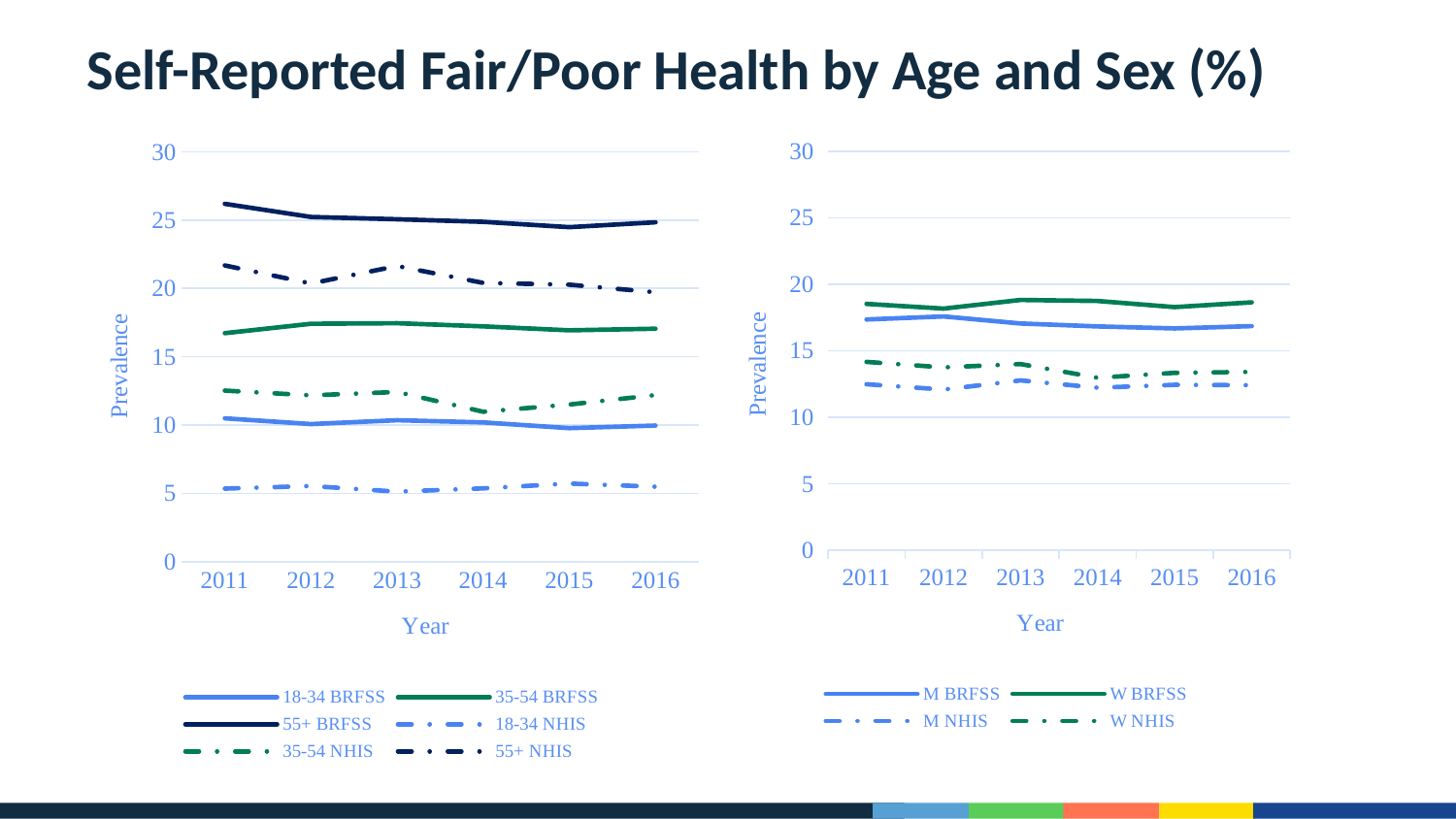
What kind of chart is the left chart on the slide? Line chart How many series does the legend of the left chart list? 6 In the left chart, which series has the highest values across all years? 55+ BRFSS In the right chart, which is larger in 2016, W BRFSS or M BRFSS? W BRFSS How many years are shown on the x axis of the right chart? 6 In the left chart, which series has the lowest values across all years? 18-34 NHIS In the right chart, is the value for W BRFSS in 2013 greater or less than 15? greater How many series does the legend of the right chart list? 4 In the left chart, is the value for 18-34 NHIS in 2011 greater or less than 10? less What is the label on the y axis of the left chart? Prevalence In the left chart, is the value for 55+ BRFSS in 2011 greater or less than 25? greater In the left chart, does the 55+ BRFSS line rise or fall from 2011 to 2016? fall